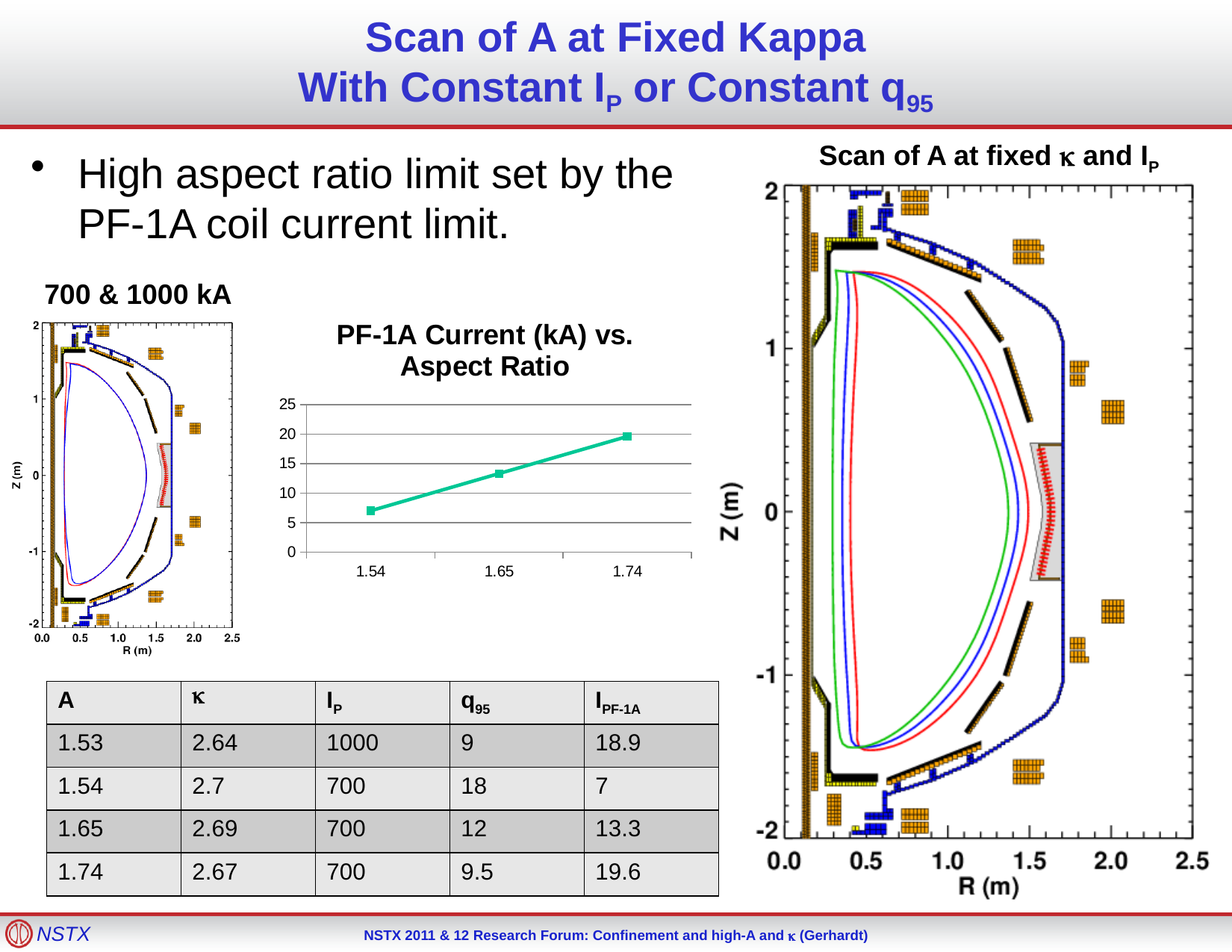
In the chart "PF-1A Current (kA) vs. Aspect Ratio", which has the larger PF-1A current: aspect ratio 1.54 or 1.65? 1.65 In the chart "PF-1A Current (kA) vs. Aspect Ratio", how many data points are plotted? 3 In the chart "PF-1A Current (kA) vs. Aspect Ratio", is the value at aspect ratio 1.74 greater or less than 25? less In the chart "PF-1A Current (kA) vs. Aspect Ratio", is the value at aspect ratio 1.74 greater or less than 15? greater In the chart "PF-1A Current (kA) vs. Aspect Ratio", does the PF-1A current rise or fall as the aspect ratio increases? rise In the chart "PF-1A Current (kA) vs. Aspect Ratio", is the value at aspect ratio 1.54 greater or less than 10? less In the chart "PF-1A Current (kA) vs. Aspect Ratio", which aspect ratio has the highest PF-1A current? 1.74 In the chart "PF-1A Current (kA) vs. Aspect Ratio", what is the highest value shown on the y axis? 25 What is the title of the line chart on the slide? PF-1A Current (kA) vs. Aspect Ratio In the chart "PF-1A Current (kA) vs. Aspect Ratio", which aspect ratio has the lowest PF-1A current? 1.54 What kind of chart is "PF-1A Current (kA) vs. Aspect Ratio"? line chart